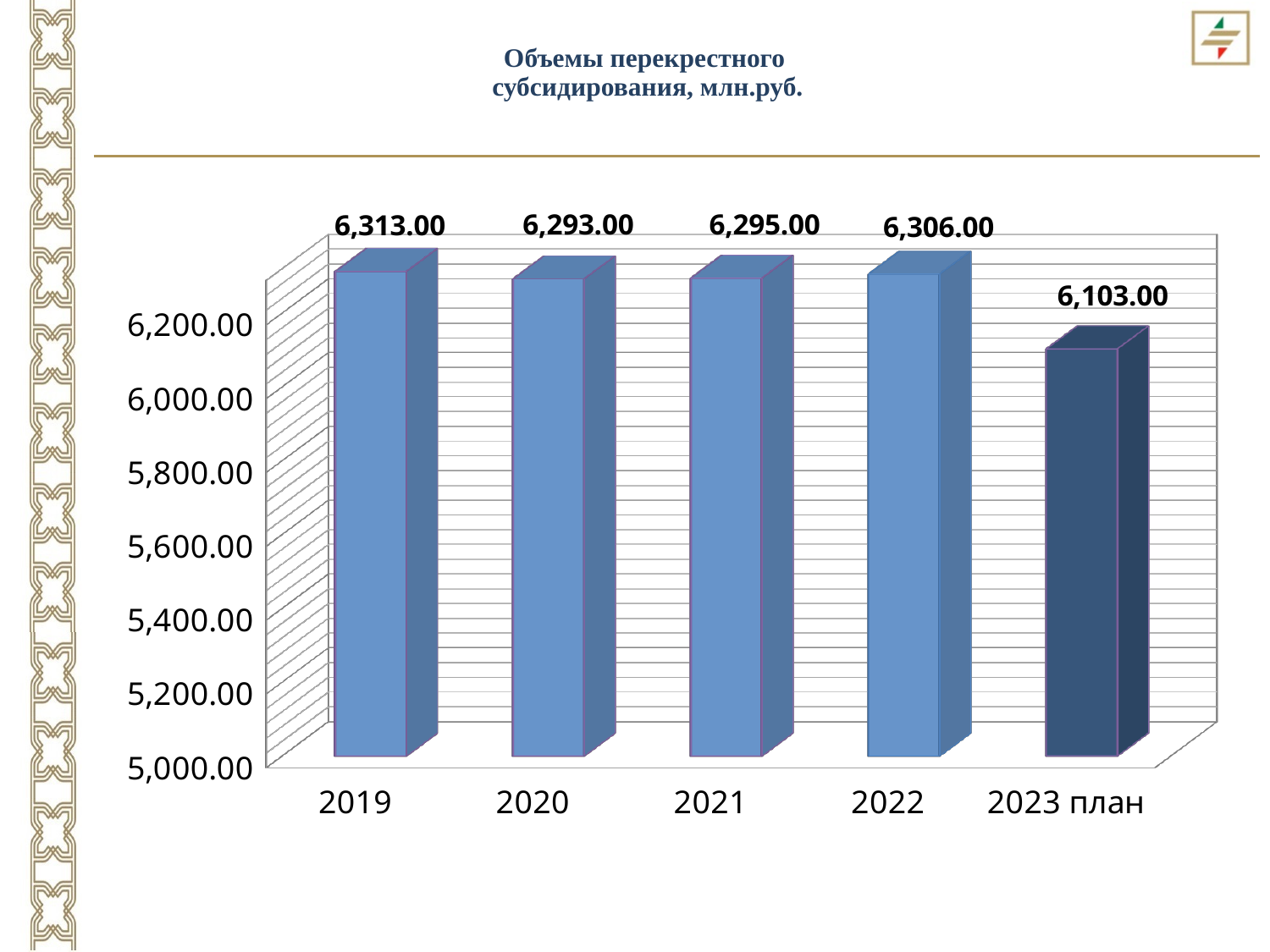
Which is larger, the value for 2022 or the value for 2023 план? 2022 What is the value for 2019? 6,313.00 What is the difference between the values for 2022 and 2023 план? 203.00 Which category has the lowest value? 2023 план What kind of chart is shown on the slide? bar chart What is the value for 2023 план? 6,103.00 What is the value for 2021? 6,295.00 What is the value for 2022? 6,306.00 Which category has the highest value? 2019 What is the difference between the values for 2019 and 2020? 20.00 What is the value for 2020? 6,293.00 How many categories are shown on the x axis? 5